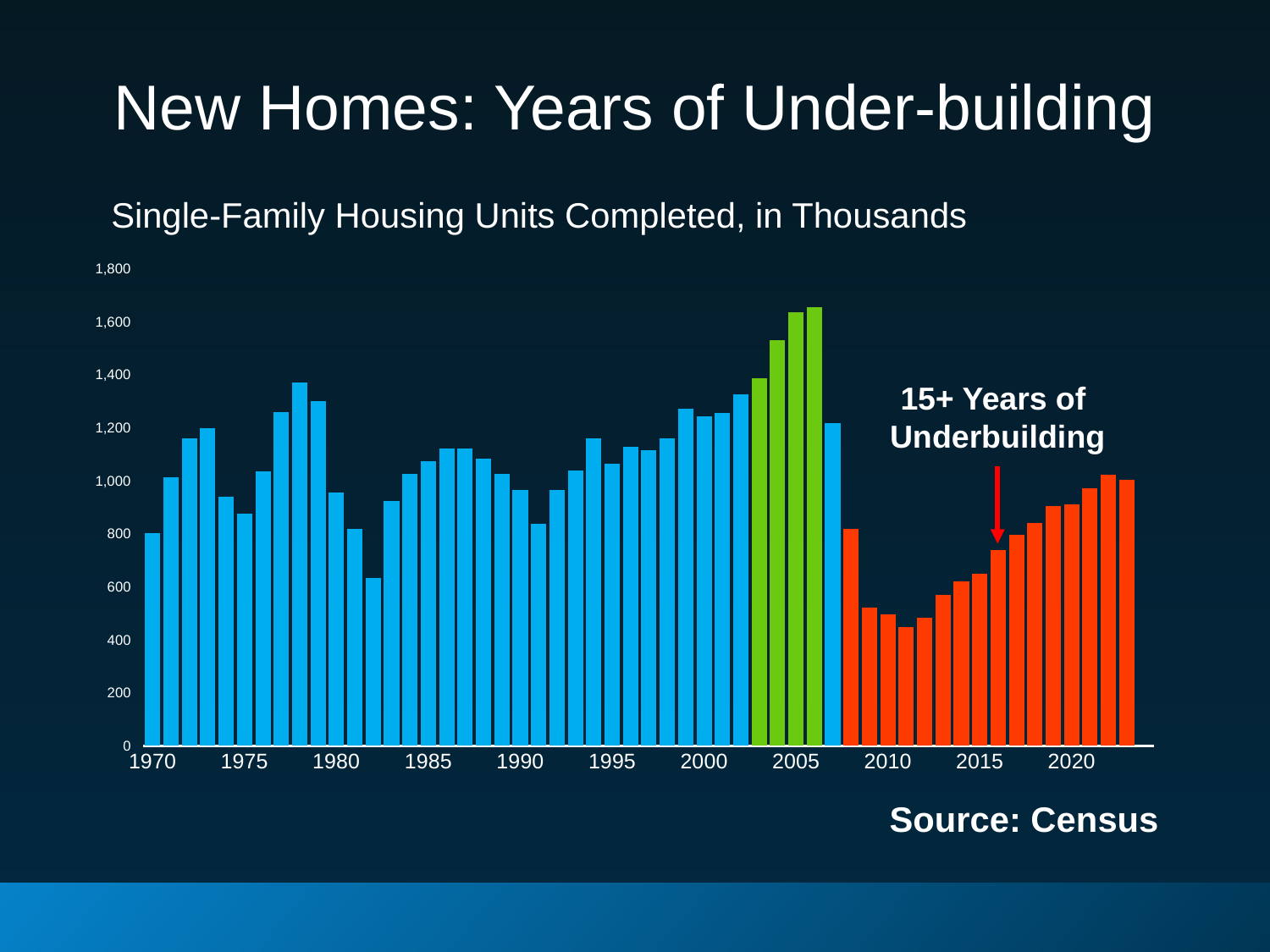
Which year has the larger value, 1982 or 2011? 1982 What is the subtitle describing the data plotted in the chart? Single-Family Housing Units Completed, in Thousands Do the values rise or fall from 2011 to 2022? Rise Which year has the larger value, 1978 or 2006? 2006 What does the annotation with the red arrow on the chart say? 15+ Years of Underbuilding Which year has the lowest number of single-family housing units completed? 2011 Is the value for 2011 greater or less than 600? less Which year has the highest number of single-family housing units completed? 2006 What kind of chart is shown on the slide? Bar chart Is the value for 2009 greater or less than 600? less Is the value for 2006 greater or less than 1,600? greater